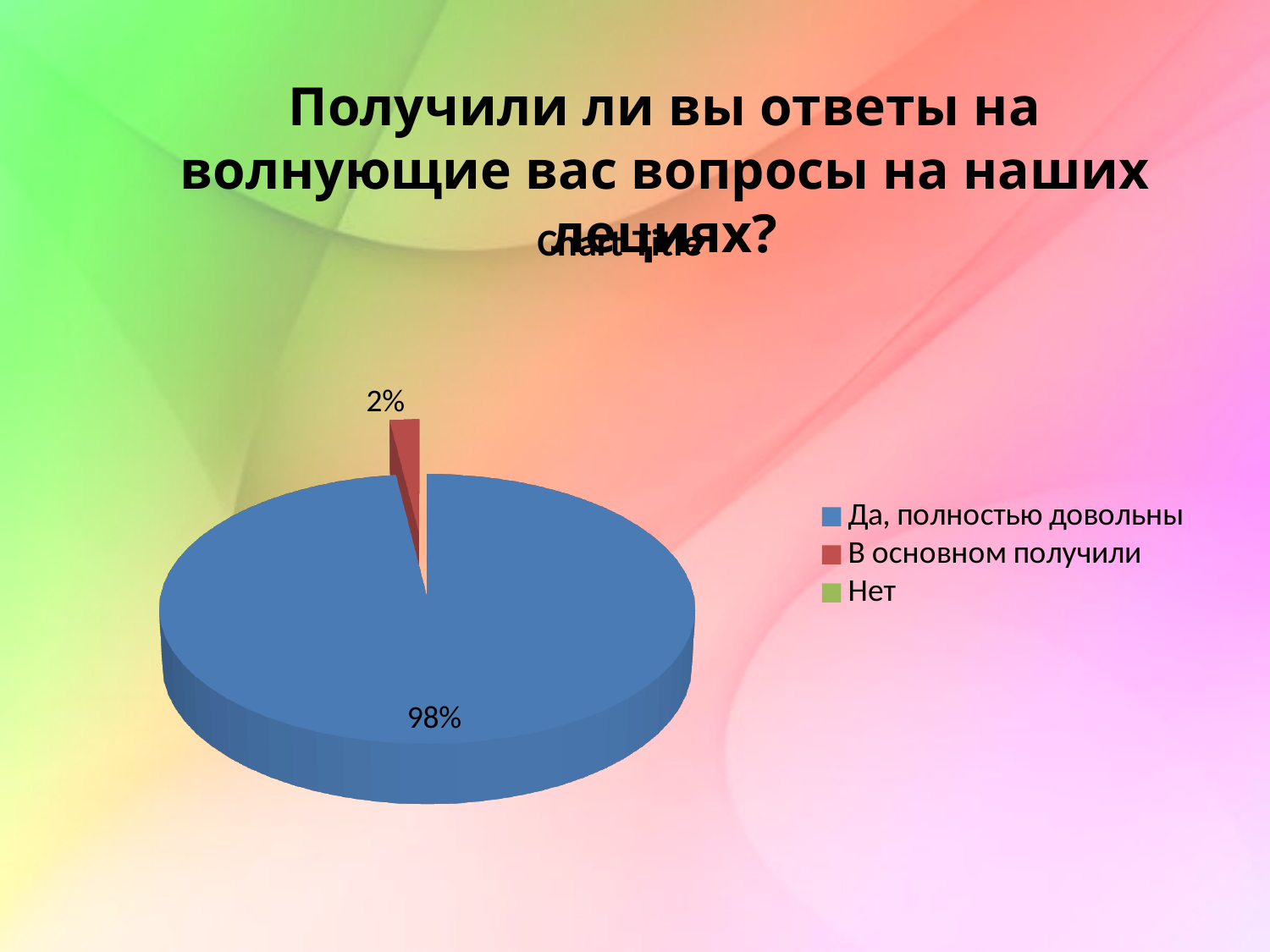
What share of the pie does the "Да, полностью довольны" slice take? 98% Which is larger, the slice for "Да, полностью довольны" or the slice for "В основном получили"? Да, полностью довольны What percentage is shown for the slice "В основном получили"? 2% Which legend entry is shown in green? Нет What is the difference in percentage points between the "Да, полностью довольны" slice and the "В основном получили" slice? 96 percentage points What percentage is shown for the slice "Да, полностью довольны"? 98% Which category has the largest slice of the pie? Да, полностью довольны How many entries does the legend list? 3 Is the value for "Да, полностью довольны" greater or less than 50%? greater What kind of chart is shown on the slide? pie chart What colour is the largest slice of the pie? blue